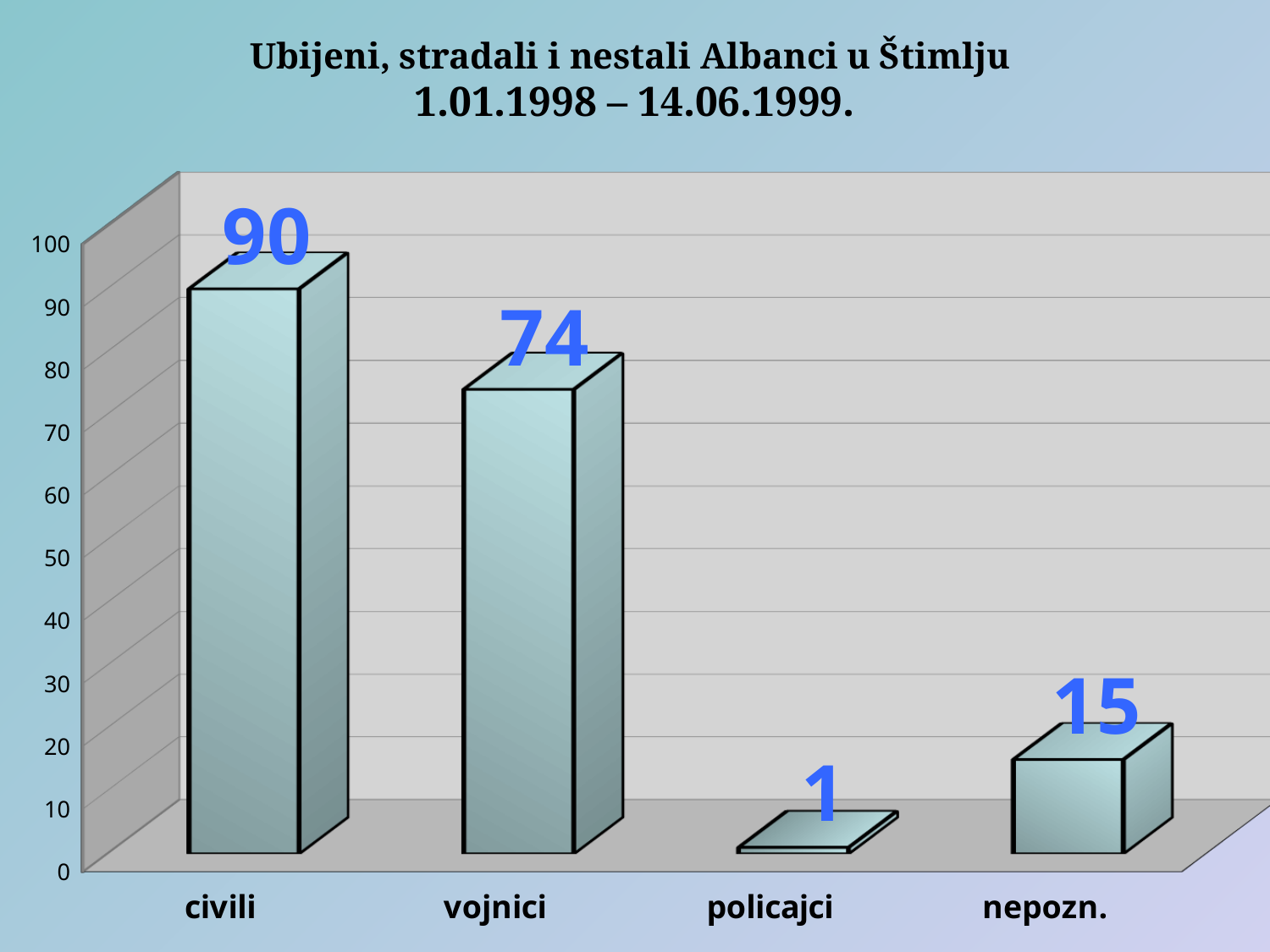
Which category has the highest value? civili What kind of chart is shown on the slide? bar chart Which category has the lowest value? policajci What is the value for policajci? 1 What is the difference between the values for civili and vojnici? 16 What is the value for civili? 90 How many categories are shown on the x axis? 4 What is the difference between the values for nepozn. and policajci? 14 What is the value for vojnici? 74 What is the title of the chart? Ubijeni, stradali i nestali Albanci u Štimlju 1.01.1998 – 14.06.1999. Which is larger, the value for vojnici or the value for nepozn.? vojnici What is the value for nepozn.? 15